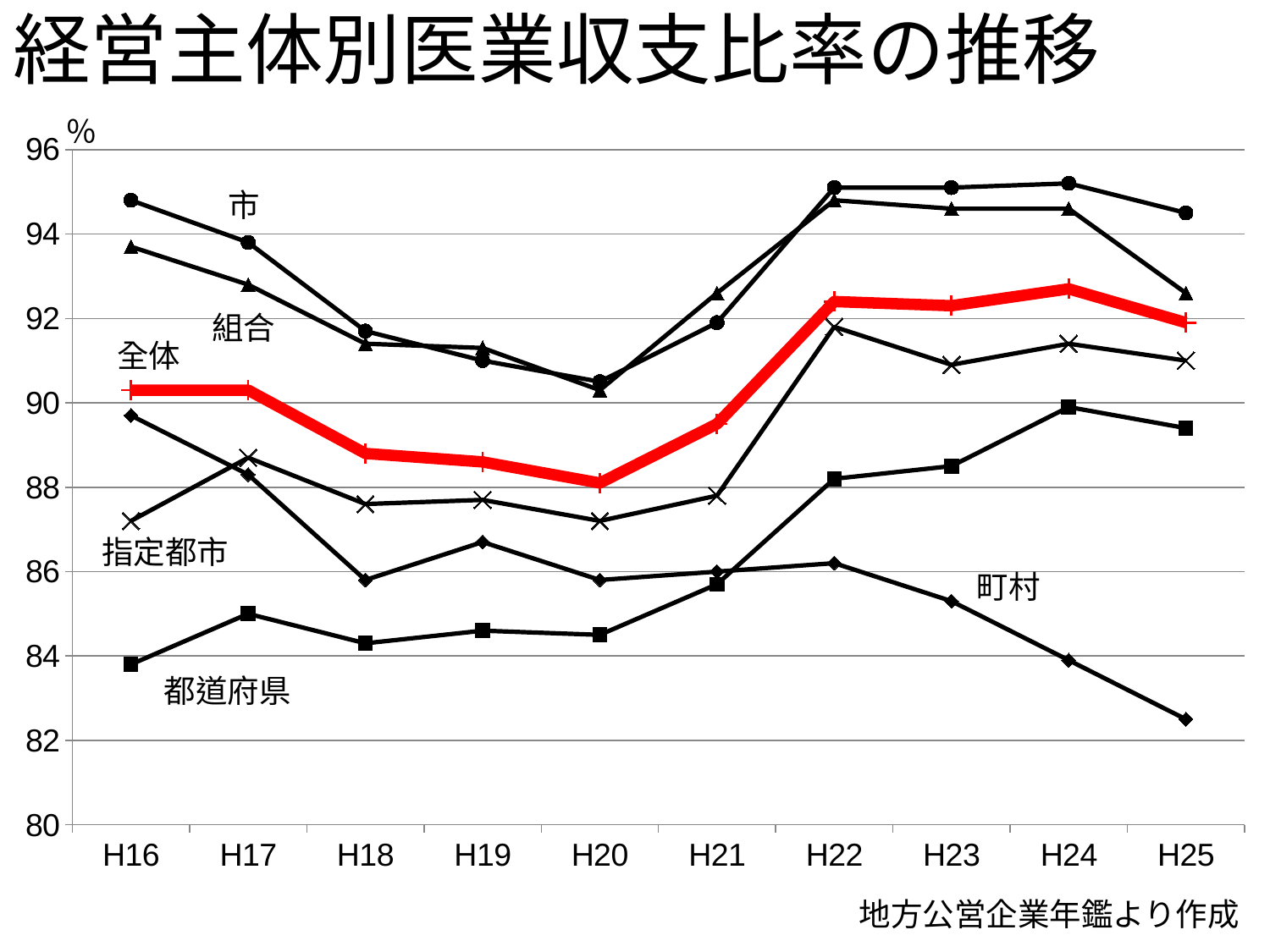
Is the value for 町村 at H25 greater or less than 84? less Does the 町村 line rise or fall from H22 to H25? fall What kind of chart is shown on the slide? line chart How many series (lines) are plotted on the chart? 6 How many years (points) are shown along the x axis? 10 Is the value for 市 at H16 greater or less than 94? greater Which series has the lowest value at H25? 町村 Which series has the lowest value at H16? 都道府県 Which series has the highest value at H25? 市 At H16, which is larger, 指定都市 or 町村? 町村 Is the value for 全体 at H20 greater or less than 90? less Which series is drawn in red? 全体